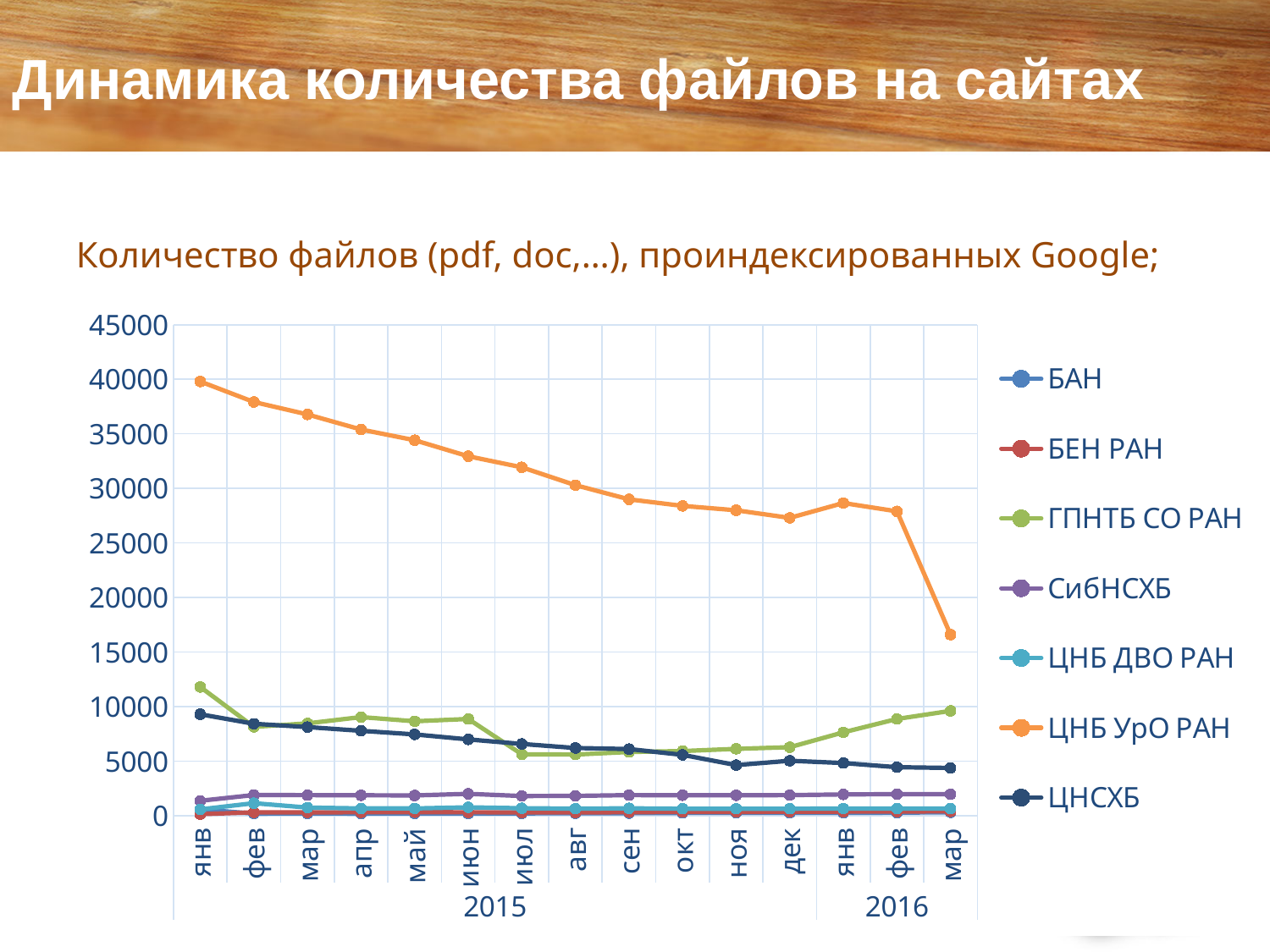
What kind of chart is shown on the slide? line chart Which series is drawn with the orange line? ЦНБ УрО РАН How many series does the legend list? 7 Which series has the highest values throughout the chart? ЦНБ УрО РАН Do the values for ЦНБ УрО РАН generally rise or fall from янв 2015 to мар 2016? fall Is the value for ЦНБ УрО РАН in янв 2015 greater or less than 35000? greater Is the value for ГПНТБ СО РАН in янв 2015 greater or less than 10000? greater Is the value for ЦНБ УрО РАН in мар 2016 greater or less than 20000? less In мар 2016, which is larger: ГПНТБ СО РАН or ЦНСХБ? ГПНТБ СО РАН Do the values for ЦНСХБ generally rise or fall from янв 2015 to мар 2016? fall How many monthly points are plotted along the x axis? 15